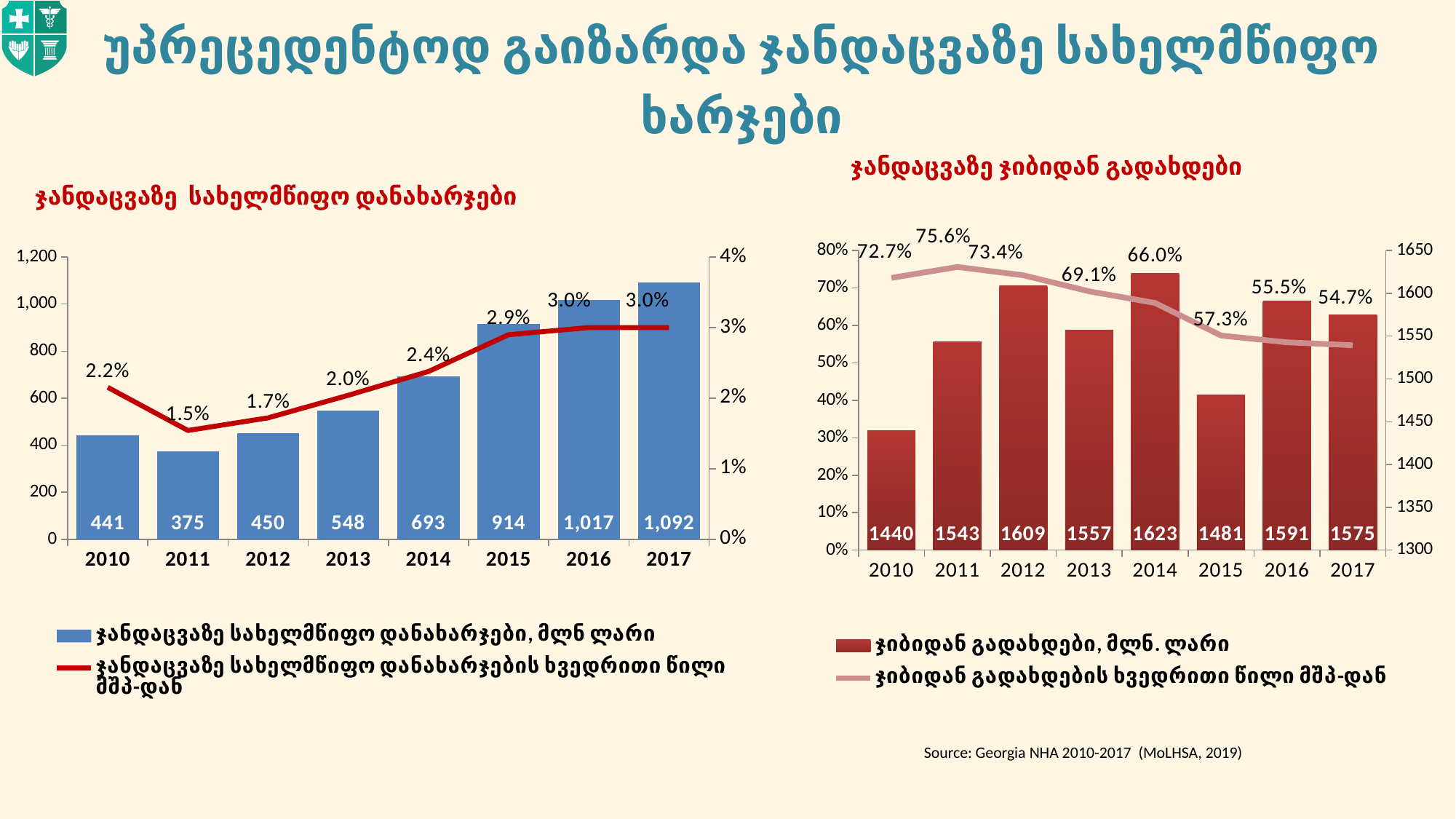
How many years are shown on the x axis of the right chart? 8 In the right chart, what is the line value for 2011? 75.6% In the left chart, which year has the lowest bar value? 2011 In the left chart, how many series does the legend list? 2 In the right chart (ჯანდაცვაზე ჯიბიდან გადახდები), what is the bar value for 2012? 1609 In the left chart, do the bar values generally rise or fall from 2011 to 2017? rise In the left chart (ჯანდაცვაზე სახელმწიფო დანახარჯები), what is the bar value for 2017? 1,092 In the right chart, which year has the highest bar value? 2014 In the right chart, which is larger, the bar value for 2013 or for 2016? 2016 In the right chart, does the line (share of GDP) rise or fall from 2011 to 2017? fall In the left chart, what is the line value (share of GDP) for 2014? 2.4% In the left chart, what is the difference between the bar values for 2015 and 2014? 221